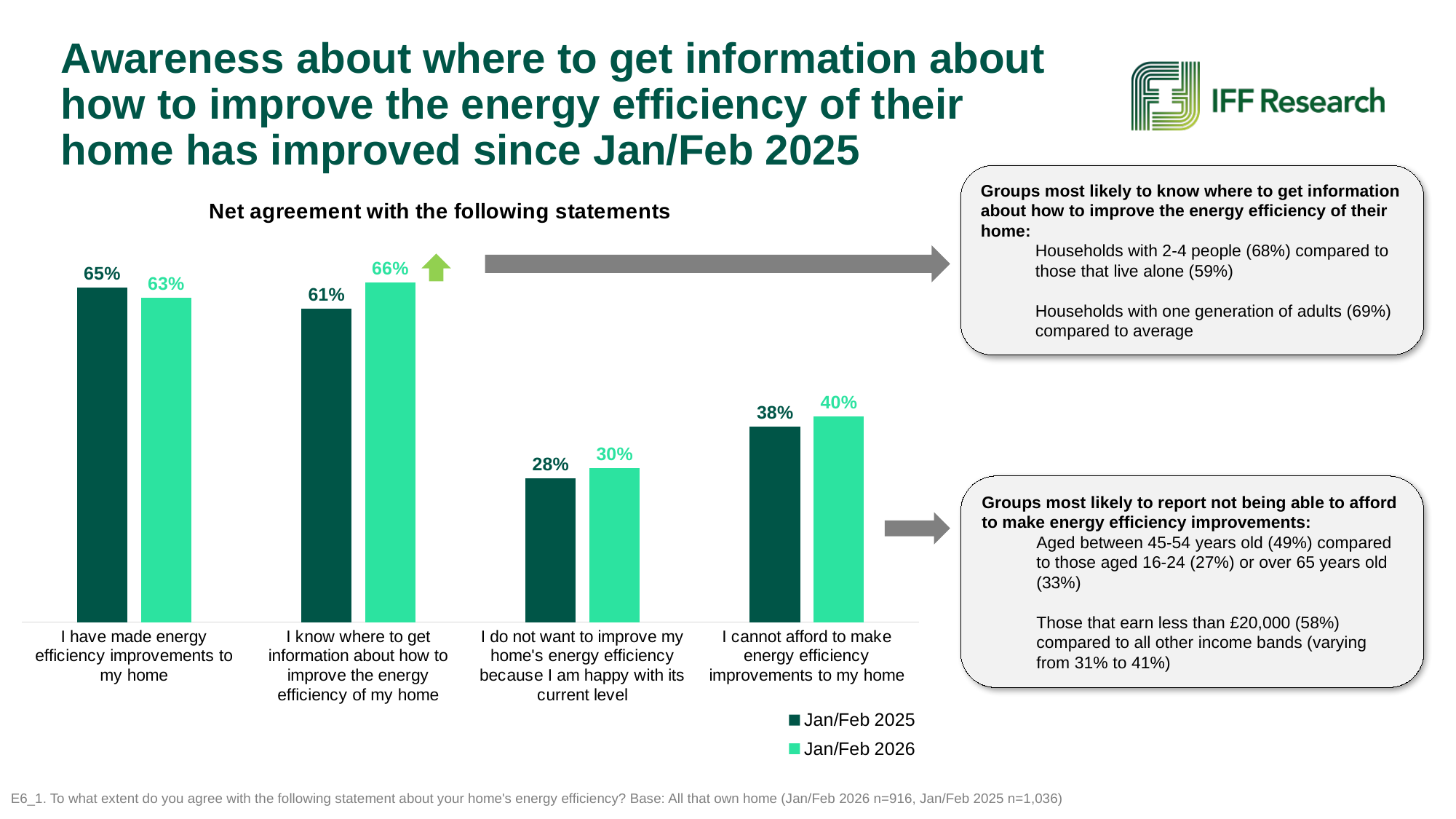
What is the Jan/Feb 2026 value for 'I cannot afford to make energy efficiency improvements to my home'? 40% For 'I have made energy efficiency improvements to my home', which is larger: the Jan/Feb 2025 value or the Jan/Feb 2026 value? Jan/Feb 2025 What is the title of the chart? Net agreement with the following statements Which statement has the highest Jan/Feb 2026 value? I know where to get information about how to improve the energy efficiency of my home How many statements (categories) are shown on the chart? 4 What is the difference between the Jan/Feb 2026 and Jan/Feb 2025 values for 'I know where to get information about how to improve the energy efficiency of my home'? 5 percentage points Which statement has the lowest Jan/Feb 2025 value? I do not want to improve my home's energy efficiency because I am happy with its current level What is the difference between the Jan/Feb 2025 and Jan/Feb 2026 values for 'I do not want to improve my home's energy efficiency because I am happy with its current level'? 2 percentage points What kind of chart is shown on the slide? Bar chart How many series does the legend list? 2 What is the Jan/Feb 2026 value for 'I know where to get information about how to improve the energy efficiency of my home'? 66% What is the Jan/Feb 2025 value for 'I have made energy efficiency improvements to my home'? 65%